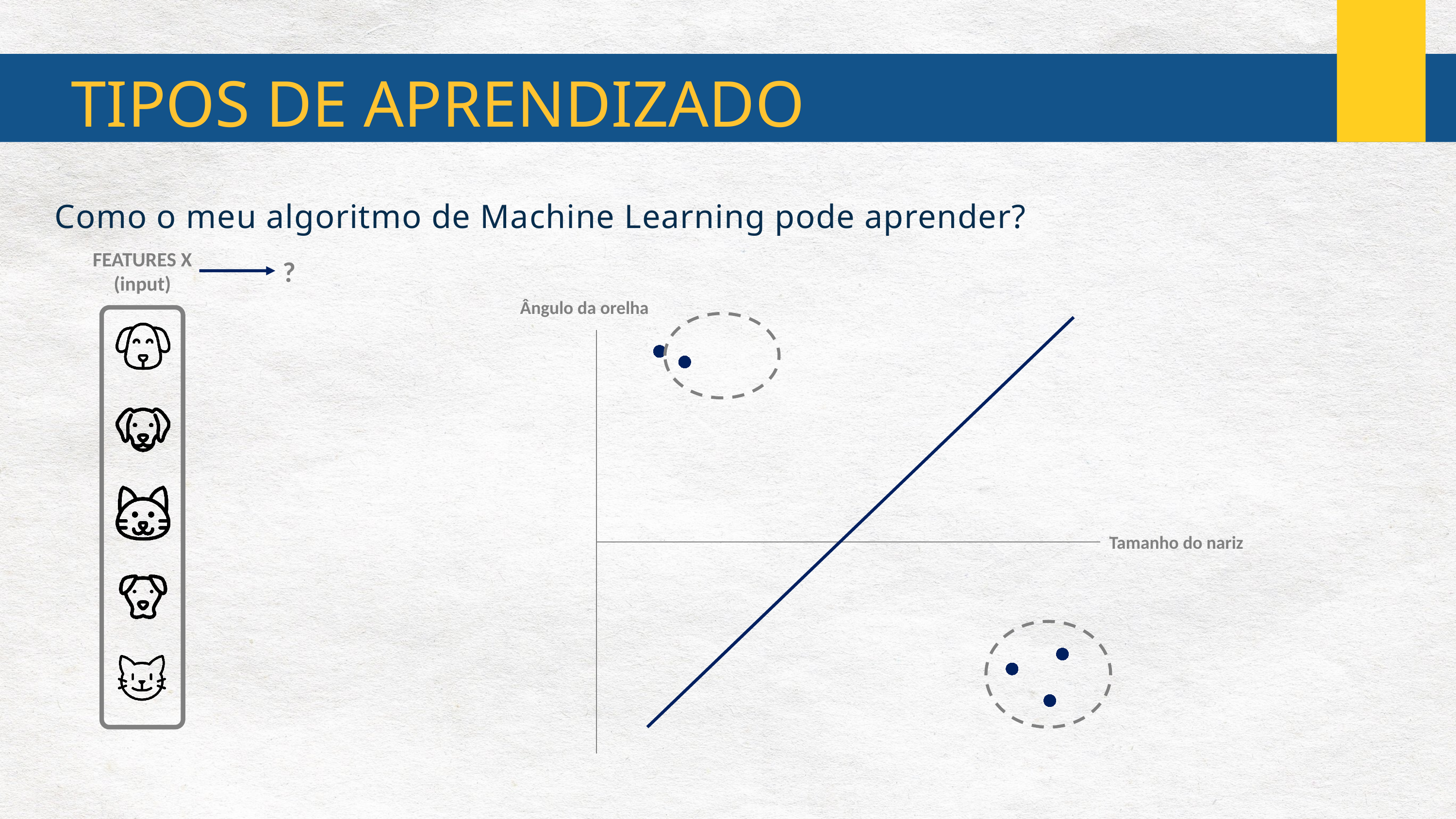
What kind of chart is shown on the slide? Scatter plot Which cluster has the larger values of Tamanho do nariz, the upper-left one or the lower-right one? Lower-right Does the diagonal line on the chart rise or fall from left to right? Rises What is the label of the vertical axis of the chart? Ângulo da orelha Which cluster has the higher values of Ângulo da orelha, the upper-left one or the lower-right one? Upper-left How many points are inside the lower-right dashed cluster? 3 What is the label of the horizontal axis of the chart? Tamanho do nariz How many dashed-outline clusters are drawn on the chart? 2 How many points are inside the upper-left dashed cluster? 2